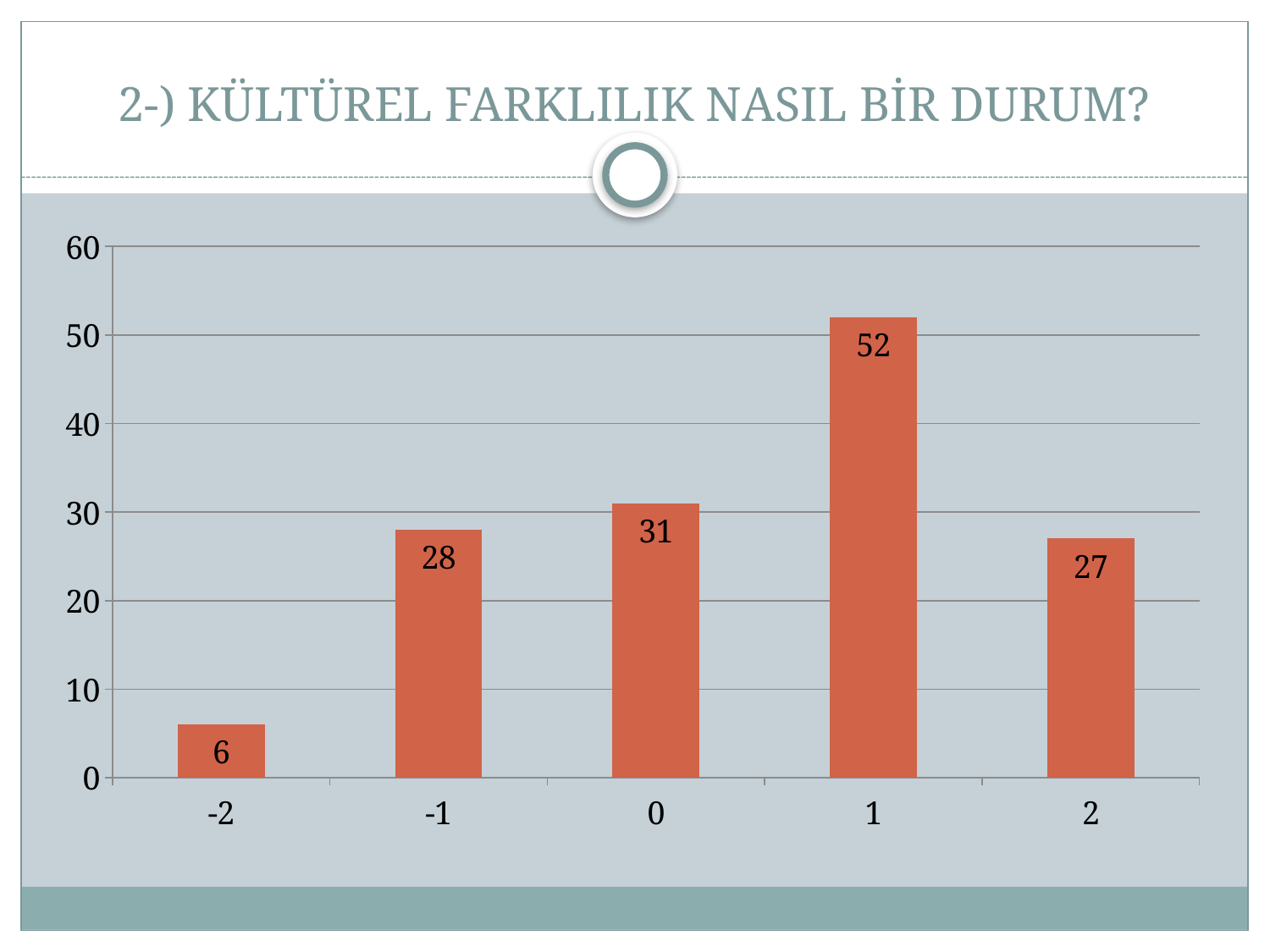
Which category has the lowest value? -2 What is the difference between the values for category -1 and category 2? 1 What kind of chart is shown on the slide? bar chart Is the value for category 1 greater or less than 50? greater What is the value for category 0? 31 How many categories are shown on the x axis? 5 What is the value for category -2? 6 Which is larger, the value for category -1 or the value for category 2? -1 What is the difference between the values for category 1 and category 0? 21 What is the value for category 1? 52 What is the title of the slide? 2-) KÜLTÜREL FARKLILIK NASIL BİR DURUM? Which category has the highest value? 1